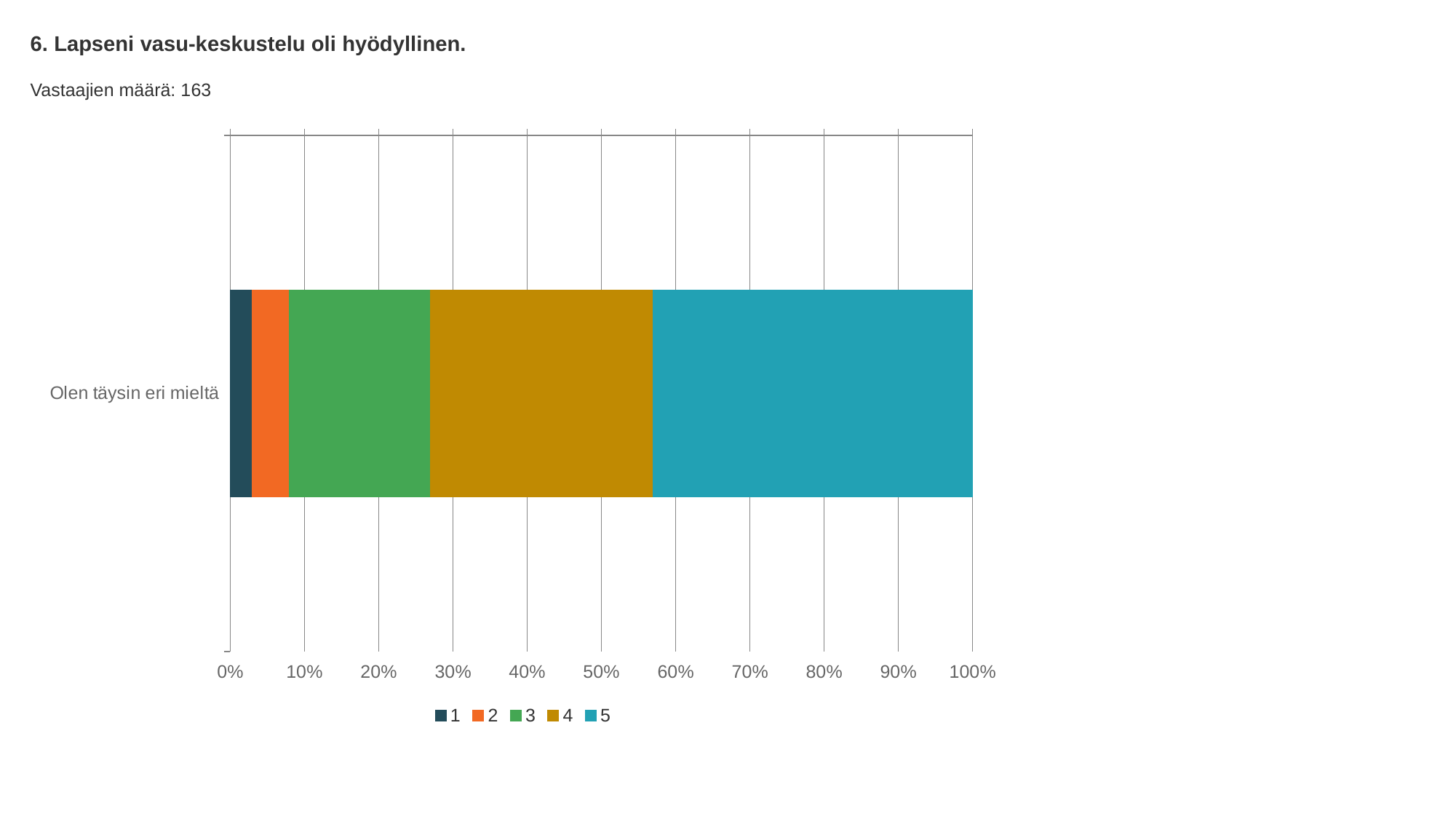
Which segment is larger, series 4 or series 3? 4 What is the total of the stacked bar, as read from the x axis? 100% How many series does the legend list? 5 How many categories are plotted on the y axis? 1 Which segment is larger, series 2 or series 5? 5 Which series occupies the largest segment of the bar? 5 Is the value for series 3 greater or less than 30%? less Is the value for series 5 greater or less than 30%? greater Is the value for series 1 greater or less than 10%? less What is the title of the chart? 6. Lapseni vasu-keskustelu oli hyödyllinen. What kind of chart is shown on the slide? Stacked bar chart Which series occupies the smallest segment of the bar? 1